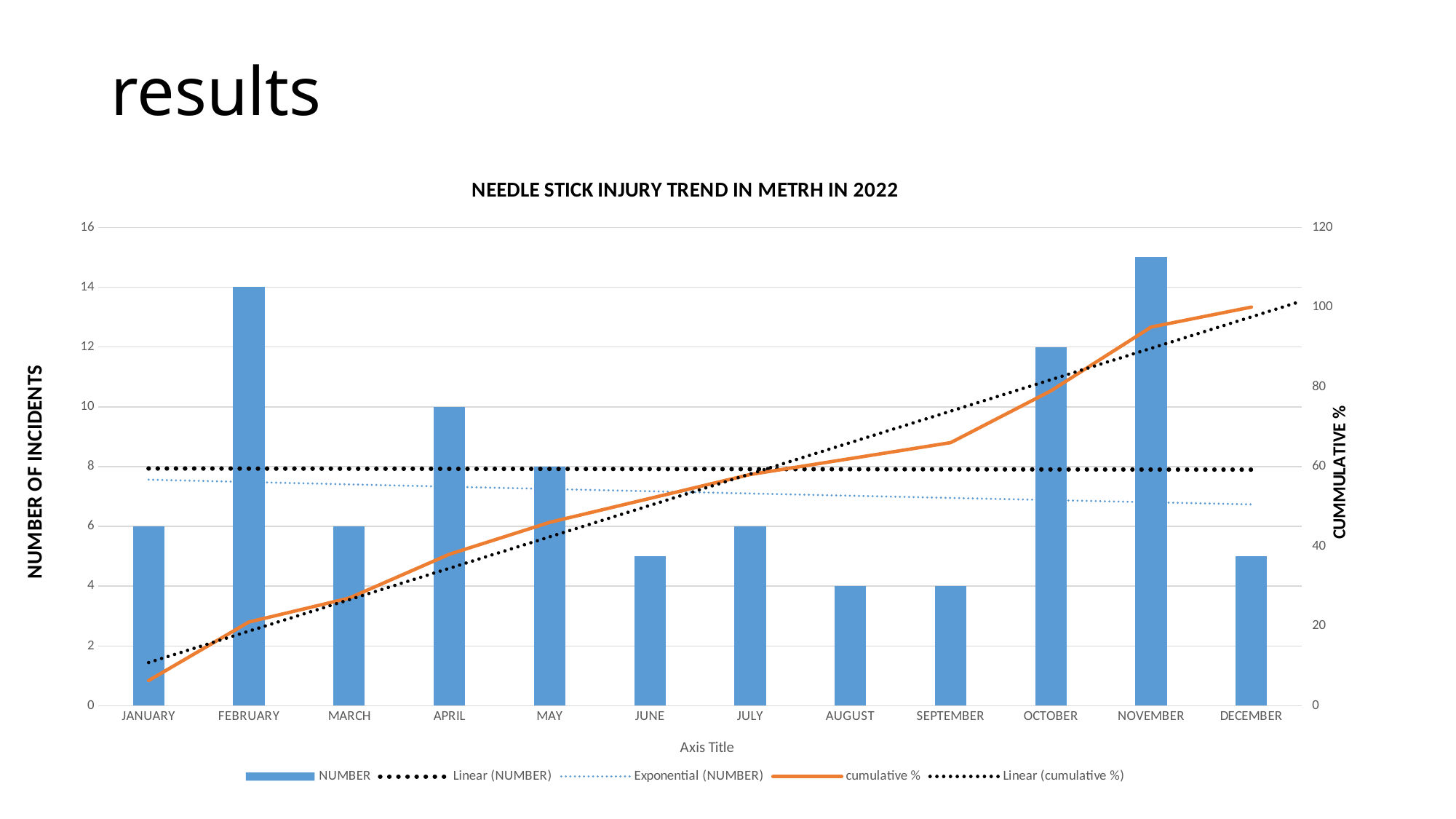
Is the number of incidents in November greater or less than 14? greater How many entries does the chart legend list? 5 What is the number of incidents in April? 10 Does the cumulative % line rise or fall from January to December? Rises What is the title of the chart? NEEDLE STICK INJURY TREND IN METRH IN 2022 Which month has more incidents, May or August? May Which month has the highest number of incidents? November What type of chart is shown on the slide? A combination bar and line chart How many months are shown on the x axis of the chart? 12 What is the difference in the number of incidents between February and January? 8 What is the number of incidents in February? 14 What is the number of incidents in October? 12